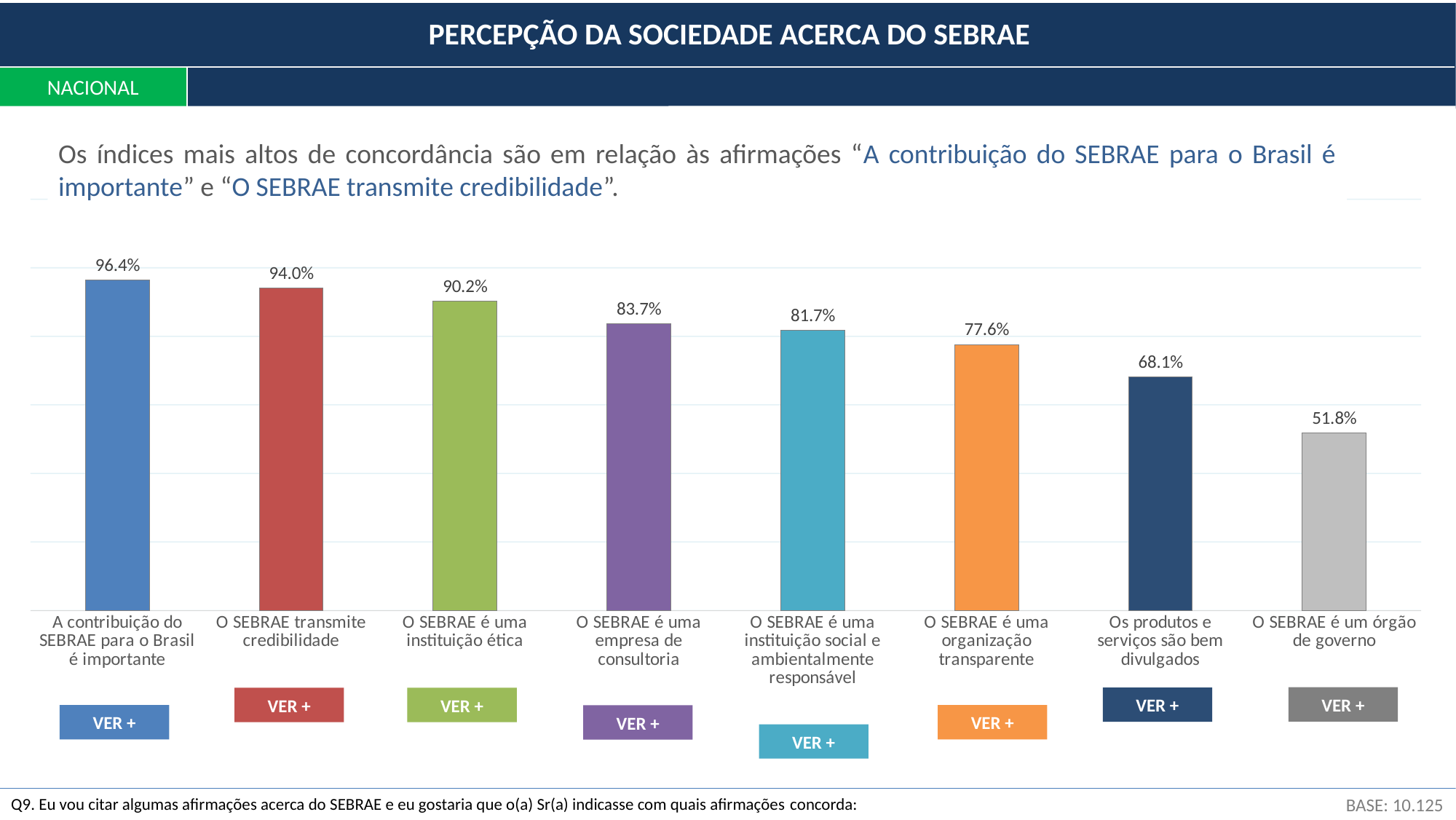
How many categories are shown in the chart? 8 Which is larger: "O SEBRAE é uma organização transparente" or "Os produtos e serviços são bem divulgados"? O SEBRAE é uma organização transparente What colour is the bar for "O SEBRAE transmite credibilidade"? Red What is the value for "Os produtos e serviços são bem divulgados"? 68.1% What is the difference between "O SEBRAE transmite credibilidade" and "O SEBRAE é um órgão de governo"? 42.2% Which category has the lowest value? O SEBRAE é um órgão de governo Do the values rise or fall from left to right along the x axis? Fall What is the value for "A contribuição do SEBRAE para o Brasil é importante"? 96.4% What kind of chart is shown on the slide? Bar chart What is the value for "O SEBRAE é uma instituição ética"? 90.2% Which category has the highest value? A contribuição do SEBRAE para o Brasil é importante What is the difference between "O SEBRAE é uma empresa de consultoria" and "O SEBRAE é uma instituição social e ambientalmente responsável"? 2.0%